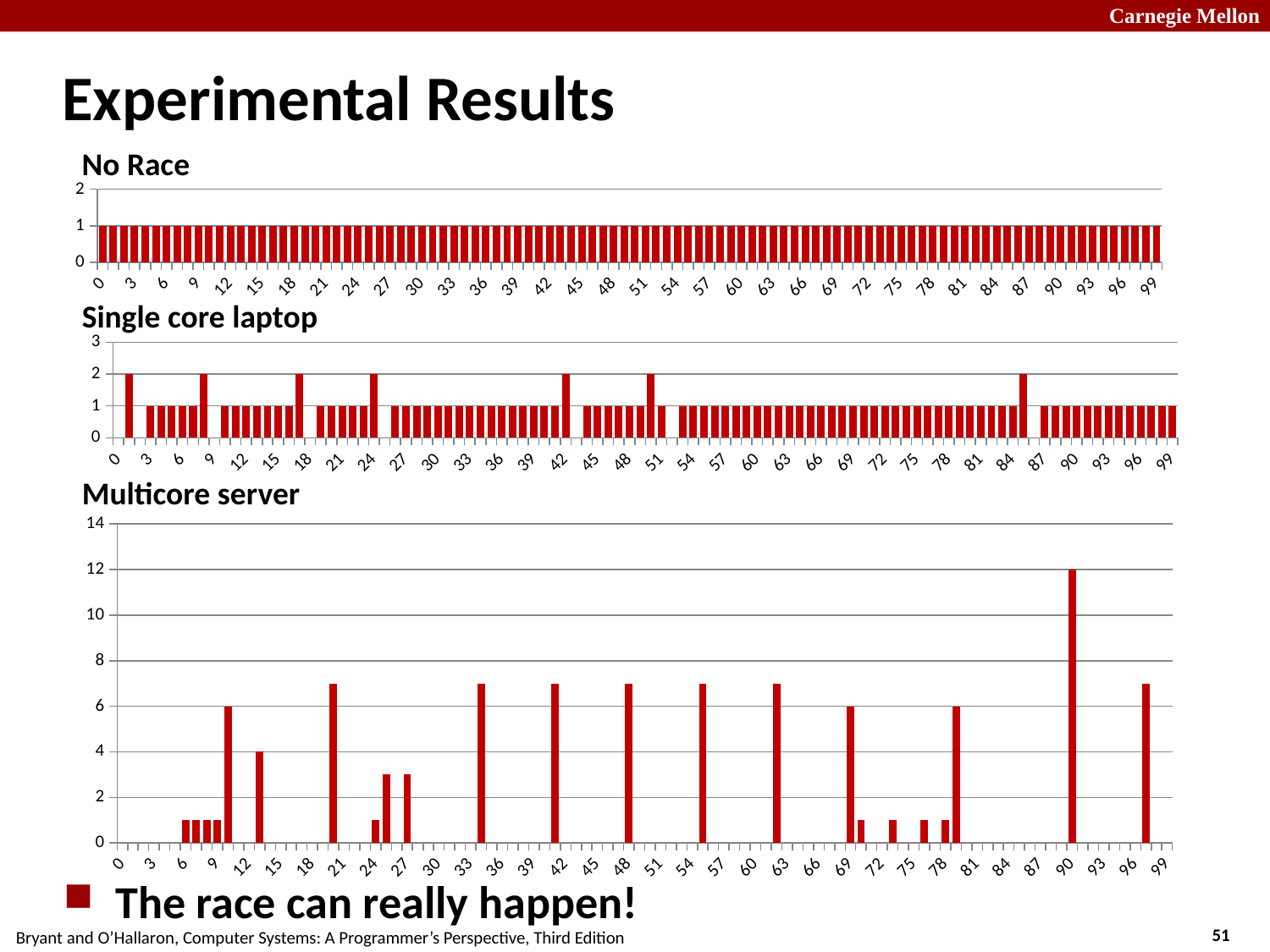
What kind of chart is the "Multicore server" chart? bar chart In the "Multicore server" chart, what is the highest tick shown on the y axis? 14 In the "Multicore server" chart, which x-axis category has the highest bar? 90 In the "Multicore server" chart, what is the value of the bar at 90? 12 In the "No Race" chart, what is the highest tick shown on the y axis? 2 In the "Multicore server" chart, is the value at 90 greater or less than 10? greater How many charts are shown on the slide? 3 In the "No Race" chart, what value does every bar reach? 1 In the "Single core laptop" chart, what is the highest value reached by any bar? 2